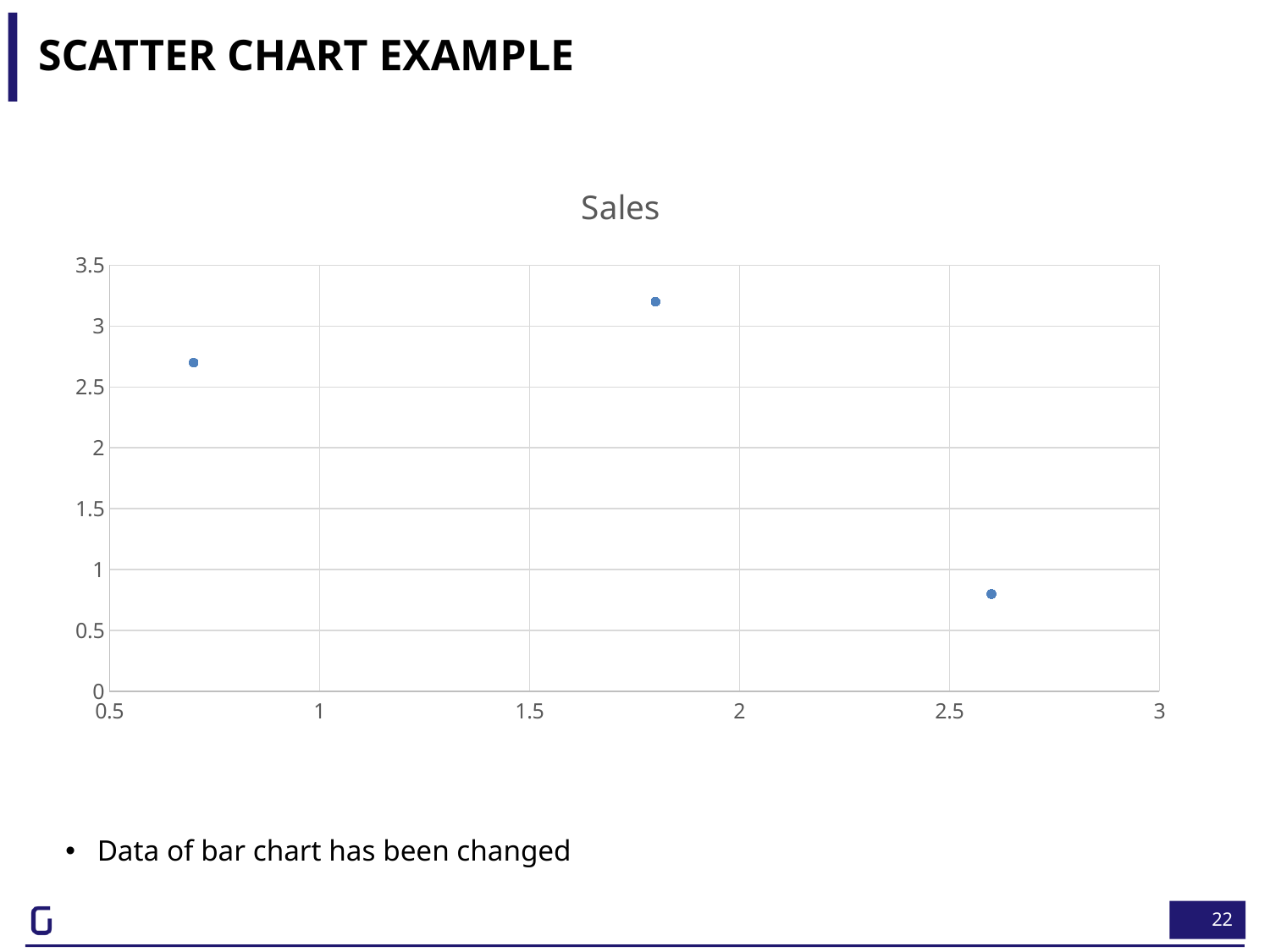
Is the y value of the rightmost point greater or less than 1? less Which has a higher y value, the leftmost point or the rightmost point? the leftmost point Which point has the lowest y value: the leftmost, the middle, or the rightmost point? the rightmost point Is the x value of the leftmost point greater or less than 1? less What kind of chart is shown on the slide? scatter chart What is the highest value shown on the vertical axis? 3.5 Which point has the highest y value: the leftmost, the middle, or the rightmost point? the middle point Is the x value of the rightmost point greater or less than 2.5? greater How many data points are plotted on the chart? 3 What is the title of the chart? Sales